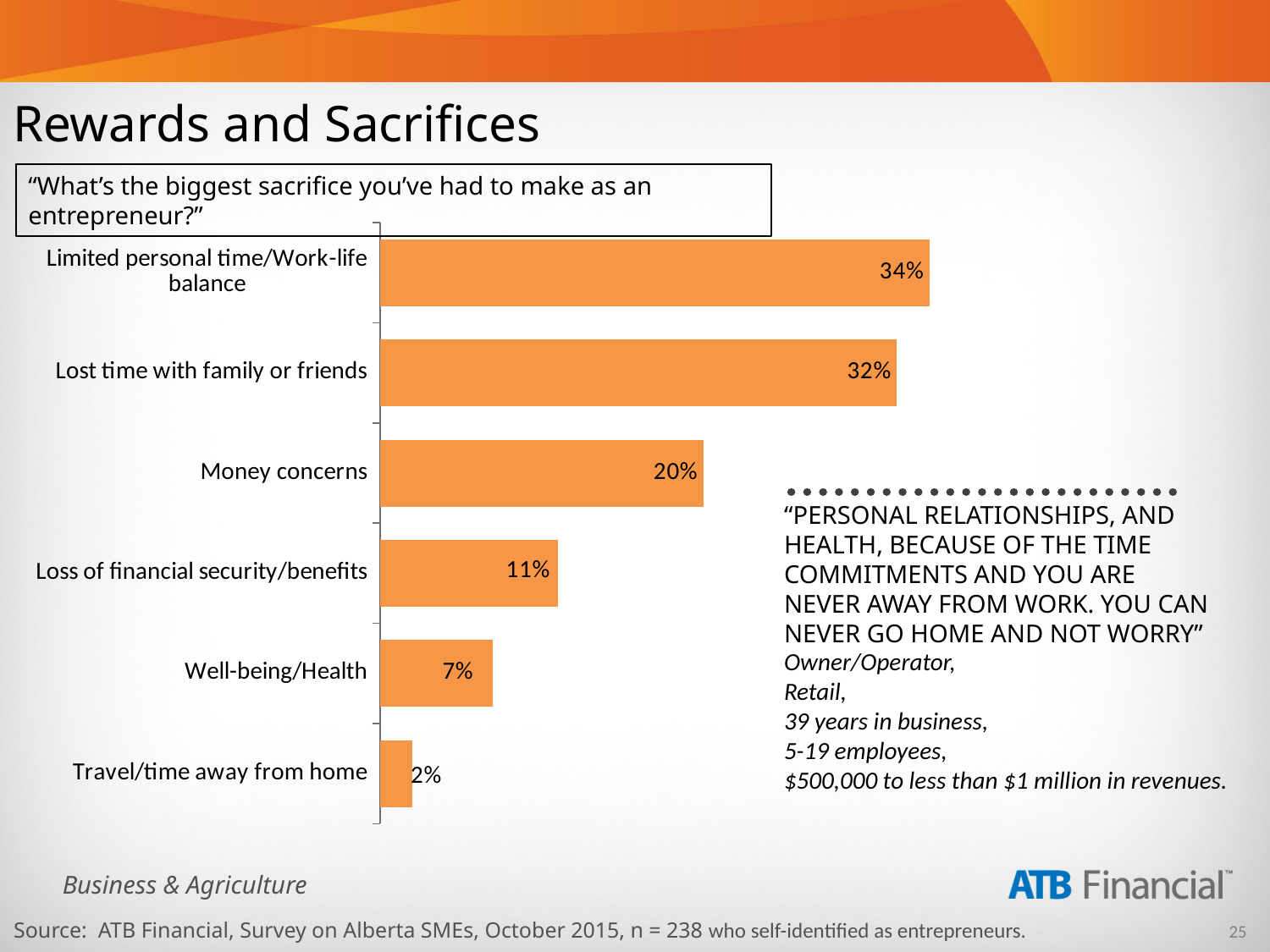
Which sacrifice has the highest percentage? Limited personal time/Work-life balance What is the value for Money concerns? 20% What is the value for Well-being/Health? 7% What is the difference between Limited personal time/Work-life balance and Lost time with family or friends? 2% What is the difference between Lost time with family or friends and Loss of financial security/benefits? 21% What survey question does the chart present responses to? "What's the biggest sacrifice you've had to make as an entrepreneur?" What is the value for Travel/time away from home? 2% Which sacrifice has the lowest percentage? Travel/time away from home What percentage of respondents named Limited personal time/Work-life balance as their biggest sacrifice? 34% Which is larger: Money concerns or Well-being/Health? Money concerns What kind of chart is shown on the slide? Bar chart How many categories are shown in the chart? 6